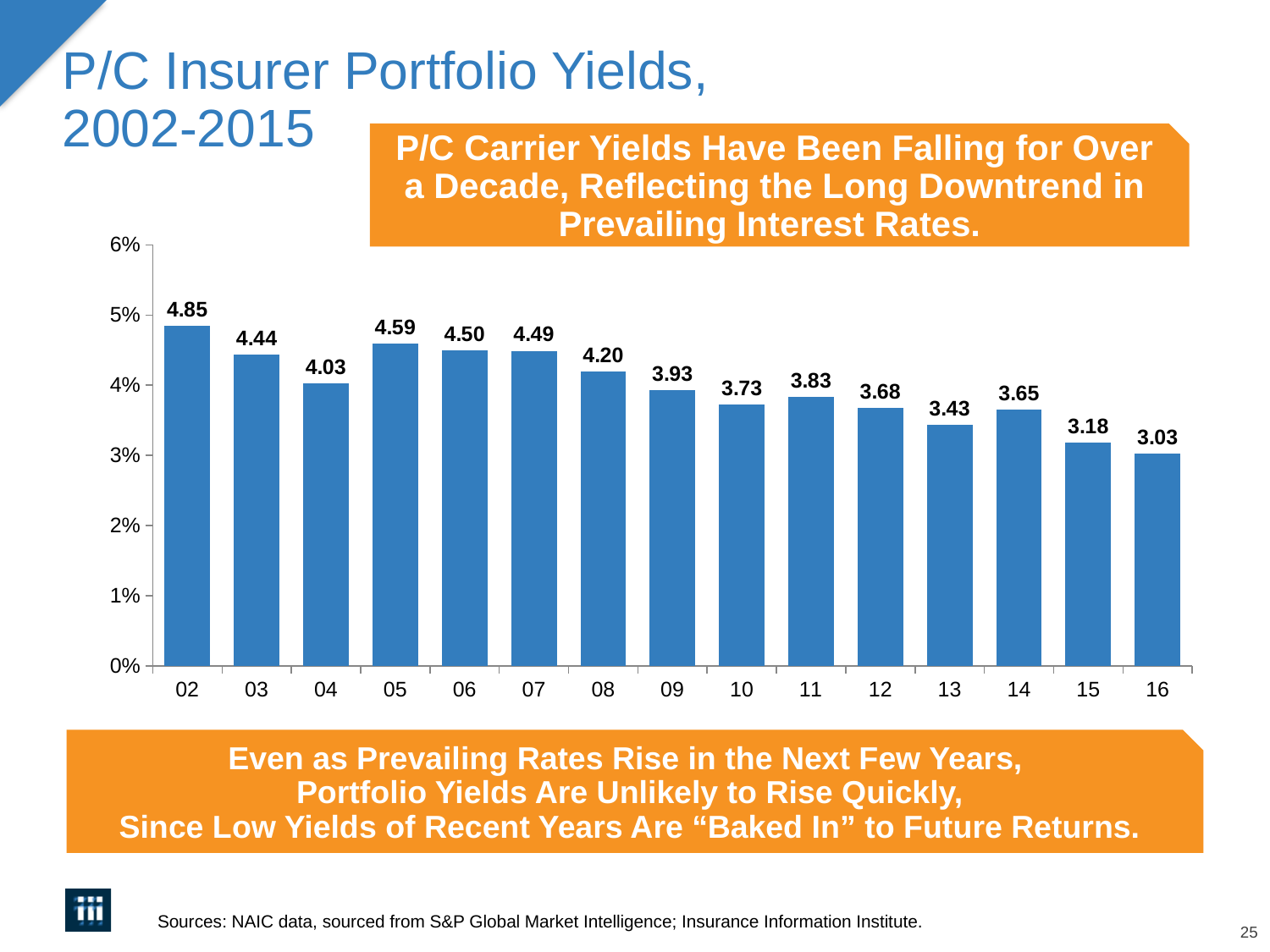
Which is larger, the value for 04 or the value for 05? 05 What is the title of the slide's chart? P/C Insurer Portfolio Yields, 2002-2015 What is the difference between the values for 02 and 16? 1.82 Which year has the lowest portfolio yield? 16 What kind of chart is shown on the slide? bar chart Is the value for 13 greater or less than 4%? less What is the portfolio yield value shown for 16? 3.03 How many years are shown on the x axis? 15 What is the portfolio yield value shown for 02? 4.85 What is the value shown for 11? 3.83 Do the portfolio yields generally rise or fall from 02 to 16? fall Which year has the highest portfolio yield? 02